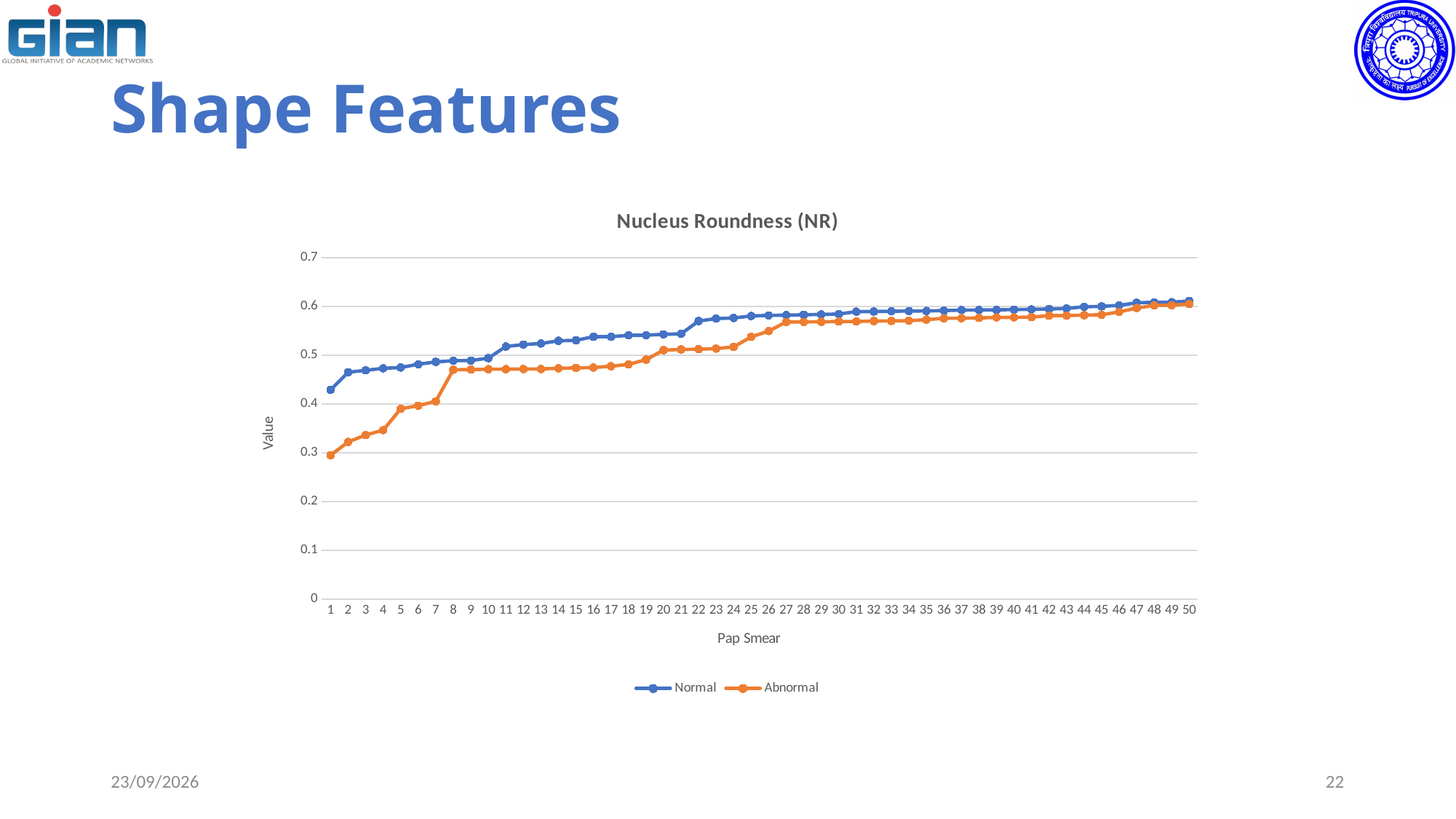
Which series has the lowest value at Pap Smear 1? Abnormal What is the title of the chart? Nucleus Roundness (NR) Is the Abnormal value at Pap Smear 10 greater or less than 0.5? less Is the Normal value at Pap Smear 30 greater or less than 0.5? greater Do the Abnormal values rise or fall as the Pap Smear number increases? rise How many Pap Smear points are plotted along the x axis? 50 Is the Normal value at Pap Smear 1 greater or less than 0.4? greater At Pap Smear 5, which series has the larger value, Normal or Abnormal? Normal What kind of chart is shown on the slide? line chart What is the label of the y axis? Value How many series does the legend list? 2